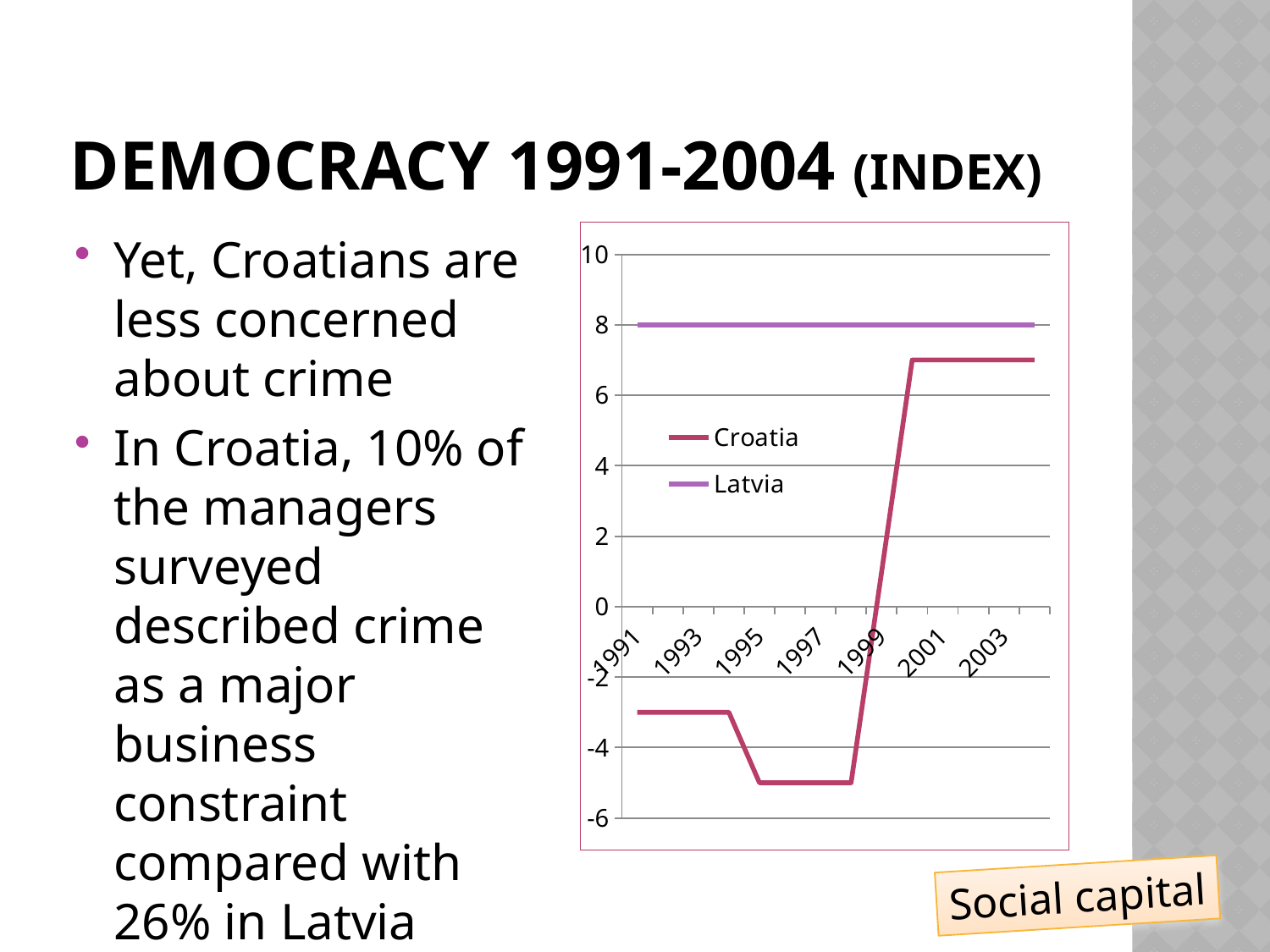
Is the value for Croatia in 1991 greater or less than -4? greater Is the value for Croatia in 2003 greater or less than 6? greater Does the Latvia line rise, fall, or stay flat across the years shown? stays flat What are the two series named in the chart's legend? Croatia and Latvia How many series does the chart's legend list? 2 Is the value for Croatia in 1997 greater or less than -4? less What kind of chart is shown on the slide? line chart What is the value for Latvia in 1995? 8 Which series has the higher value in 1993, Croatia or Latvia? Latvia What is the title of the slide containing the chart? Democracy 1991-2004 (Index) Does the Croatia line rise or fall between 1999 and 2001? rises Which is larger for Croatia, the value in 1993 or the value in 1997? 1993